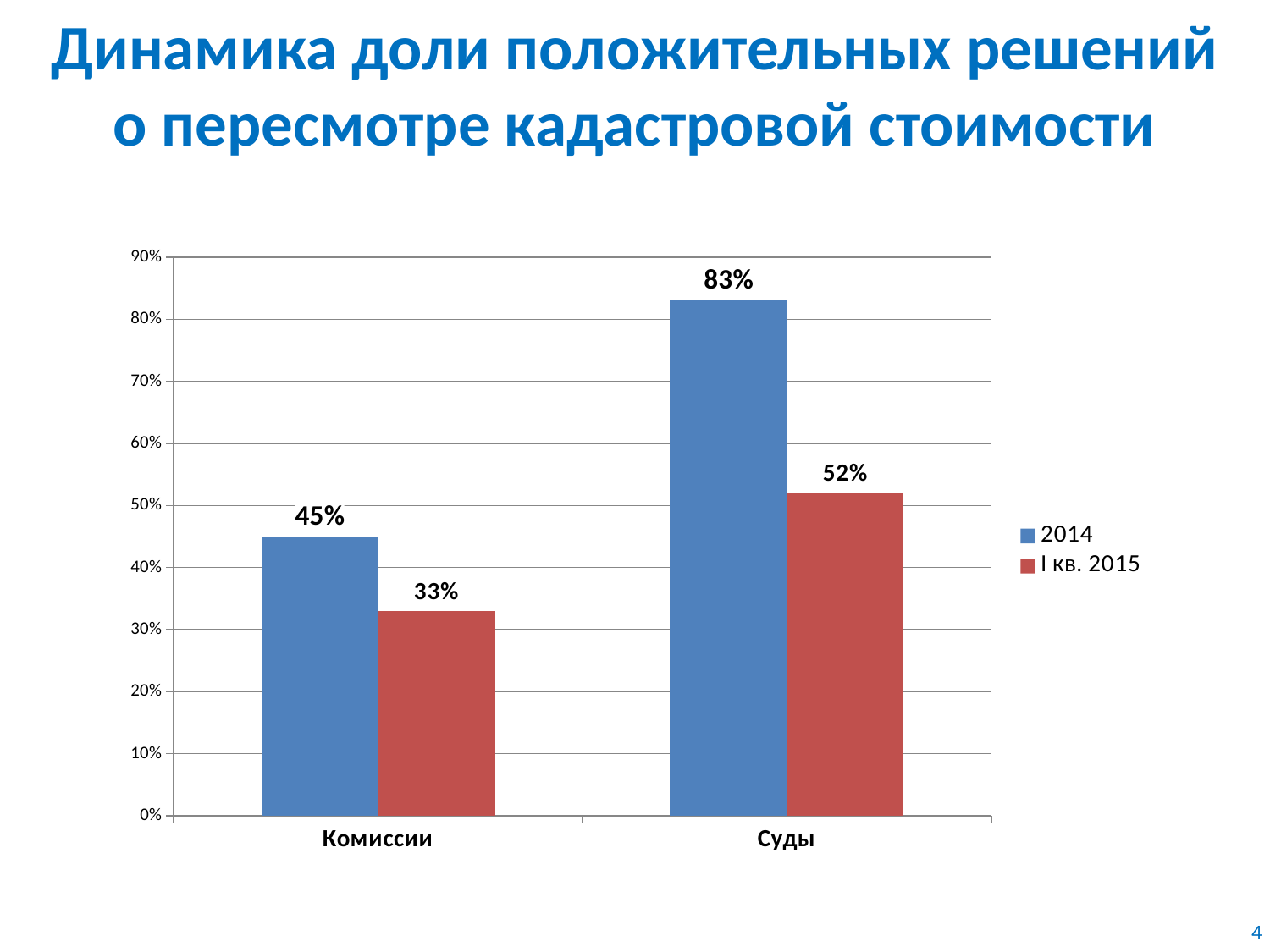
How many series does the legend list? 2 What is the difference between the 2014 and I кв. 2015 values for Суды? 31% Which category has the lowest value in the I кв. 2015 series? Комиссии What kind of chart is shown on the slide? Bar chart What is the value for Суды in I кв. 2015? 52% What is the value for Суды in 2014? 83% Which is larger: the I кв. 2015 value for Суды or the 2014 value for Комиссии? I кв. 2015 value for Суды What is the value for Комиссии in 2014? 45% What is the difference between the 2014 and I кв. 2015 values for Комиссии? 12% How many categories are shown on the x axis? 2 What is the value for Комиссии in I кв. 2015? 33% Which category has the highest value in the 2014 series? Суды